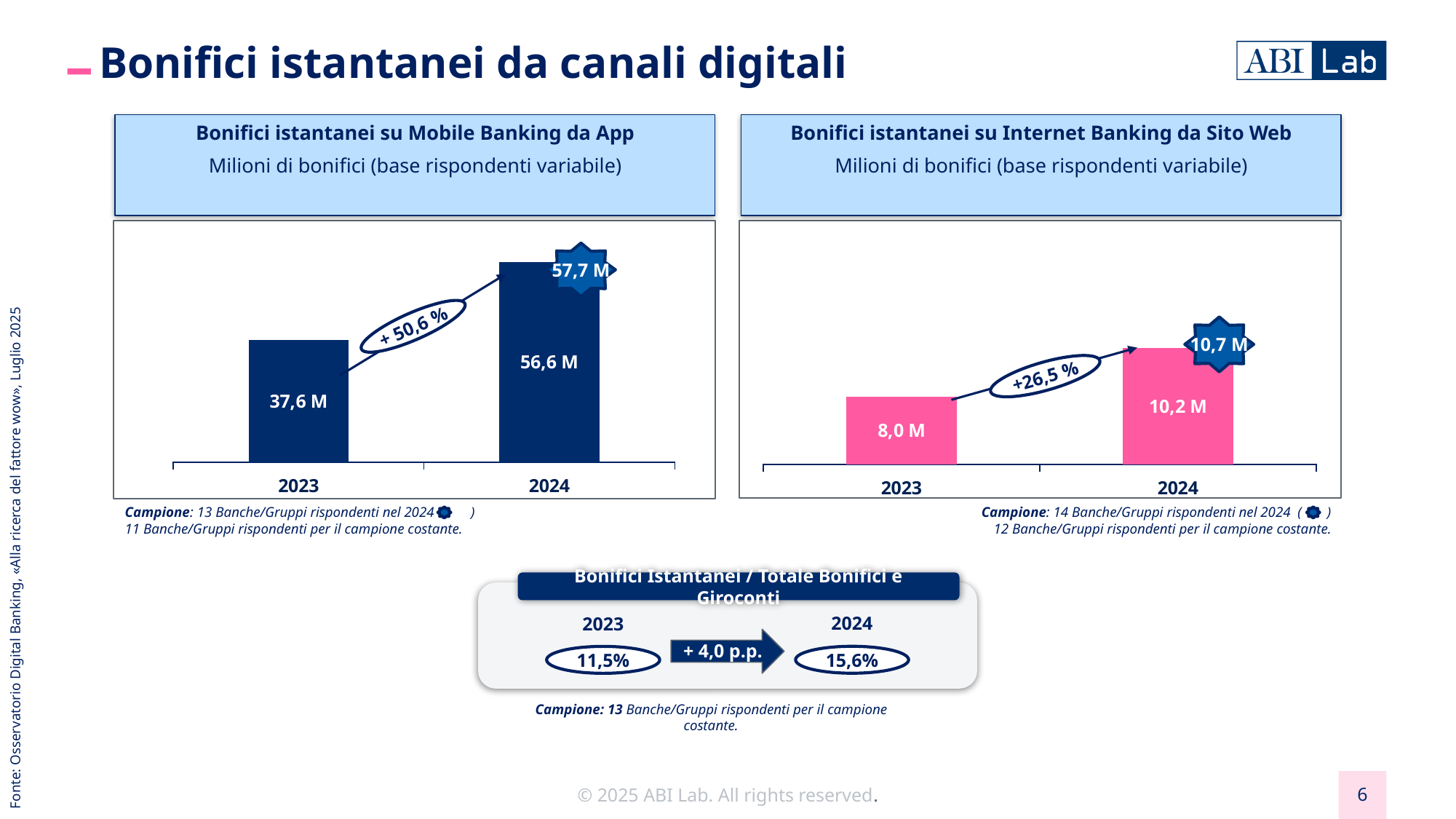
In the chart 'Bonifici istantanei su Mobile Banking da App', what value is printed on the 2024 bar? 56,6 M In the chart 'Bonifici istantanei su Internet Banking da Sito Web', what percentage growth is shown between 2023 and 2024? +26,5 % In the chart 'Bonifici istantanei su Mobile Banking da App', what is the difference between the 2024 bar value (56,6 M) and the 2023 bar value (37,6 M)? 19,0 M In the chart 'Bonifici istantanei su Mobile Banking da App', what percentage growth is shown between 2023 and 2024? + 50,6 % In the chart 'Bonifici istantanei su Internet Banking da Sito Web', what is the difference between the 2024 bar value (10,2 M) and the 2023 bar value (8,0 M)? 2,2 M In the chart 'Bonifici istantanei su Mobile Banking da App', what is the value for 2023? 37,6 M In the chart 'Bonifici istantanei su Mobile Banking da App', which year has the higher value? 2024 How many years are shown on the x axis of the chart 'Bonifici istantanei su Mobile Banking da App'? 2 In the chart 'Bonifici istantanei su Internet Banking da Sito Web', which year has the lower value? 2023 What kind of chart is 'Bonifici istantanei su Internet Banking da Sito Web'? Bar chart In the chart 'Bonifici istantanei su Internet Banking da Sito Web', what is the value for 2023? 8,0 M In the chart 'Bonifici istantanei su Internet Banking da Sito Web', what value is printed on the 2024 bar? 10,2 M